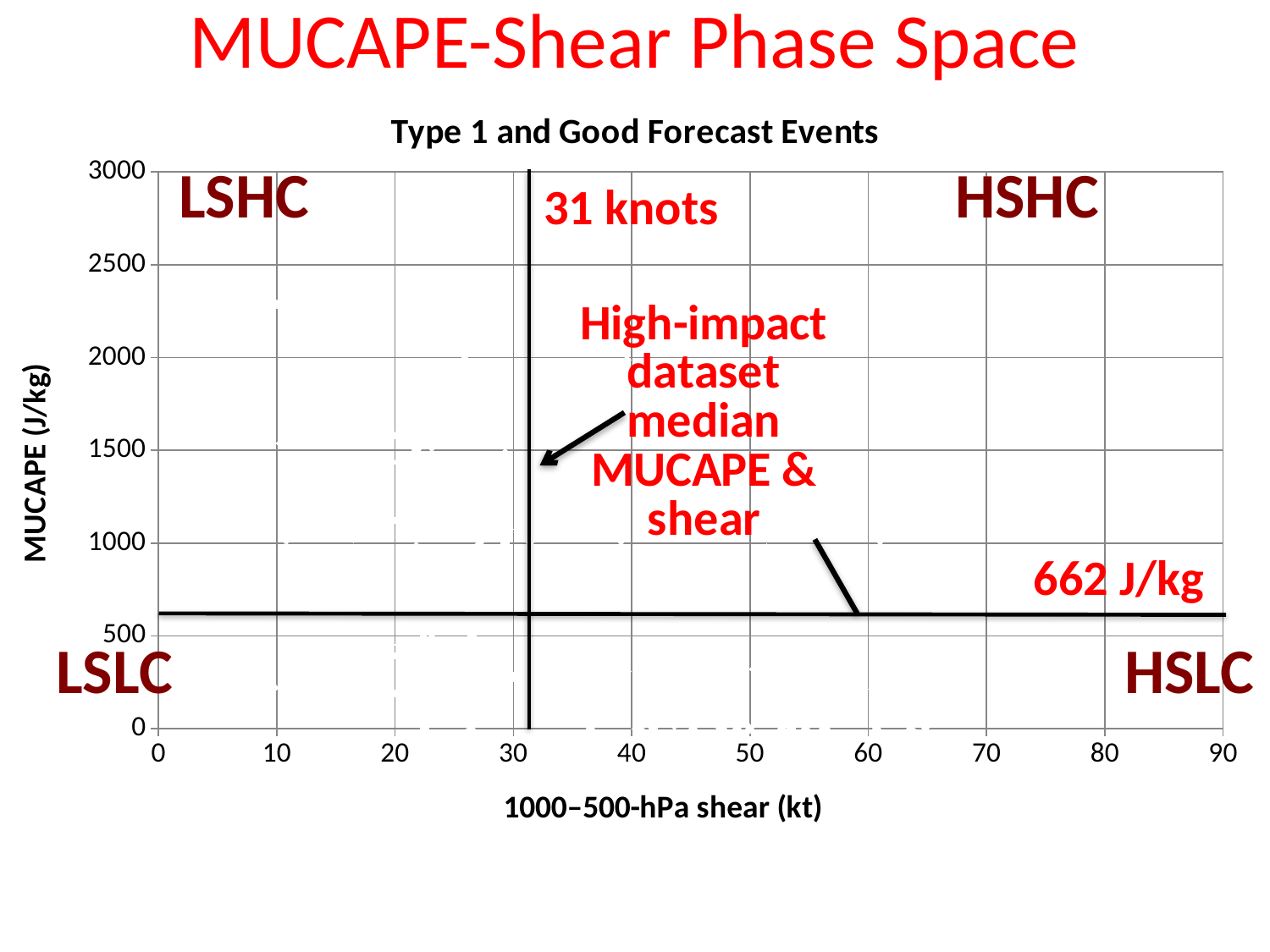
Is the vertical reference line on the chart at a shear value greater or less than 30? greater Which quadrant label appears in the lower-left region of the chart? LSLC Is the horizontal reference line on the chart at a MUCAPE value greater or less than 500? greater What MUCAPE value does the horizontal reference line on the chart mark? 662 J/kg How many quadrant labels are shown on the chart? 4 What is the maximum value shown on the y axis of the chart? 3000 Which quadrant label appears in the upper-right region of the chart? HSHC What is the label of the y axis of the chart? MUCAPE (J/kg) What is the label of the x axis of the chart? 1000–500-hPa shear (kt) What is the title of the chart on the slide? Type 1 and Good Forecast Events What shear value does the vertical reference line on the chart mark? 31 knots What is the maximum value shown on the x axis of the chart? 90